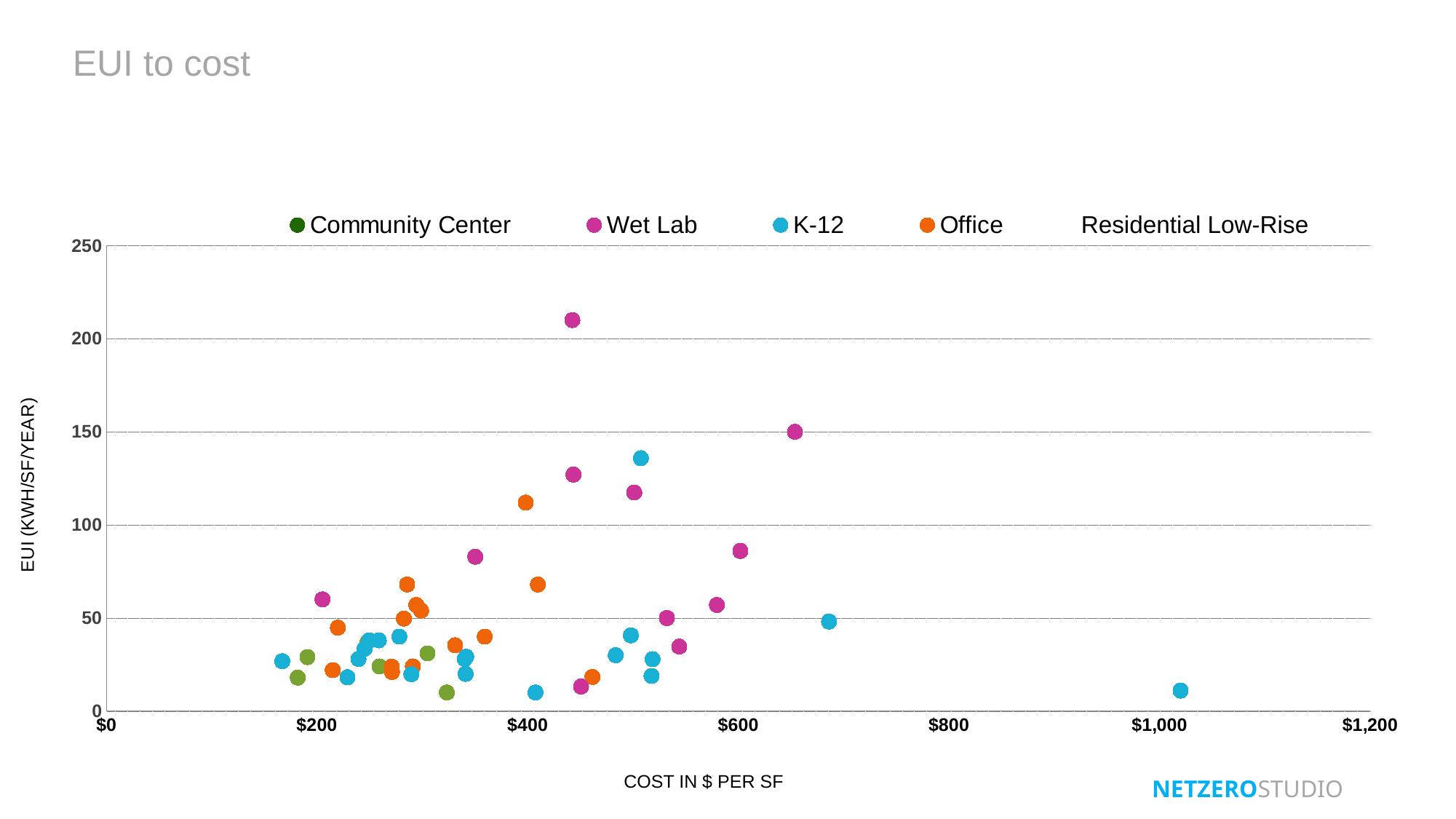
Which series contains the point with the highest EUI value on the chart? Wet Lab What kind of chart is shown on the slide? scatter chart What is the highest value shown on the horizontal axis? $1,200 Is the EUI value of the highest Office point greater or less than 150? less Which series contains the point with the highest cost per square foot on the chart? K-12 Is the EUI value of the highest K-12 point greater or less than 100? greater What is the title of the chart? EUI to cost Is the EUI value of the highest Wet Lab point greater or less than 200? greater What is the label of the vertical axis? EUI (KWH/SF/YEAR) How many series does the legend list? 5 Which series has a higher maximum EUI value, Wet Lab or Office? Wet Lab